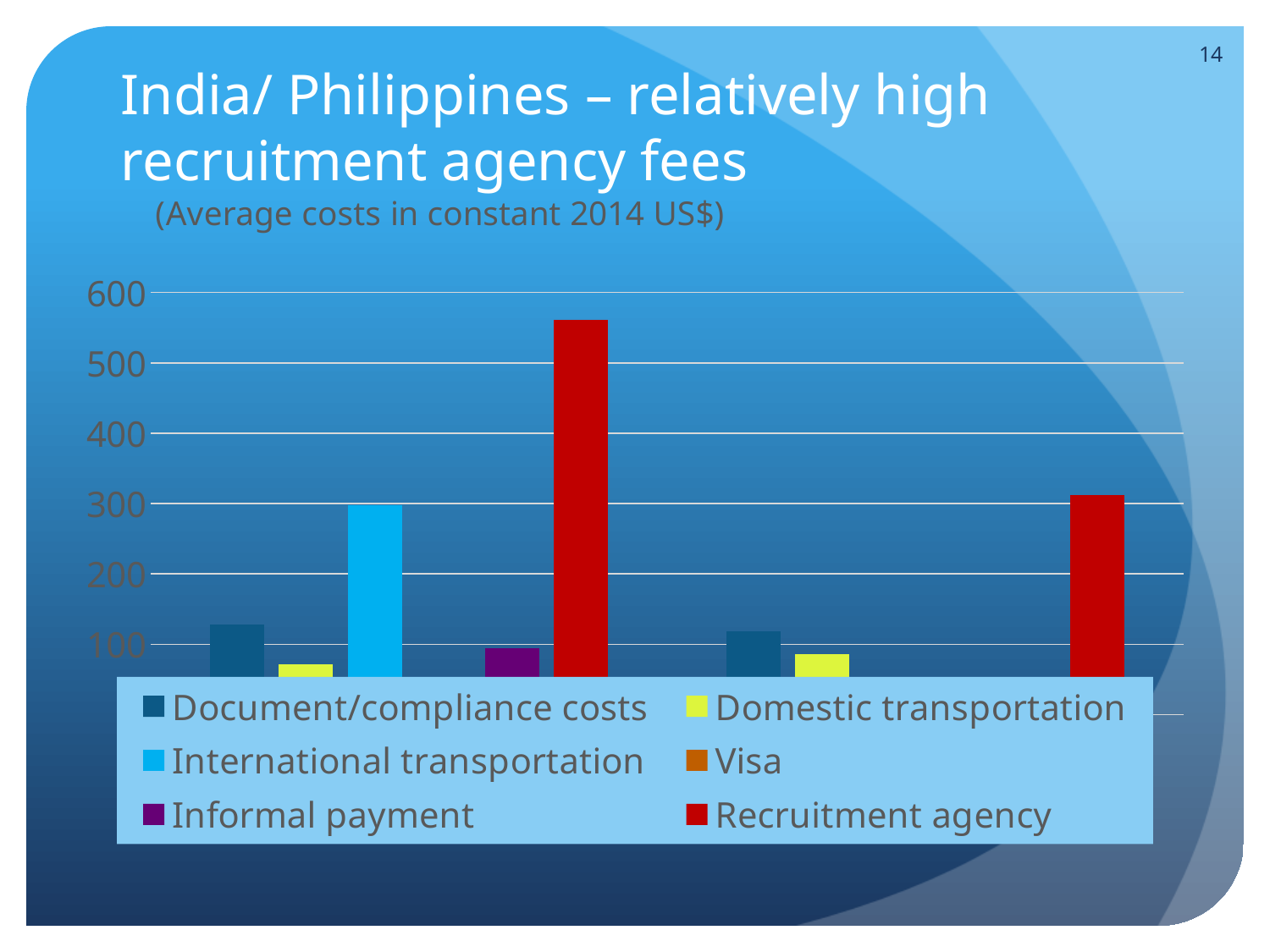
In the right group of bars, which series has the highest value? Recruitment agency Is the Recruitment agency value in the left group greater or less than 500? greater How many series does the legend list? 6 What colour represents Recruitment agency in the legend? red How many groups of bars are plotted in the chart? 2 Is the International transportation value in the left group greater or less than 200? greater In the left group, which is larger: Document/compliance costs or Domestic transportation? Document/compliance costs Which is larger: the Recruitment agency value in the left group or in the right group? left group What kind of chart is shown on the slide? bar chart Is the Recruitment agency value in the right group greater or less than 400? less In the left group of bars, which series has the highest value? Recruitment agency